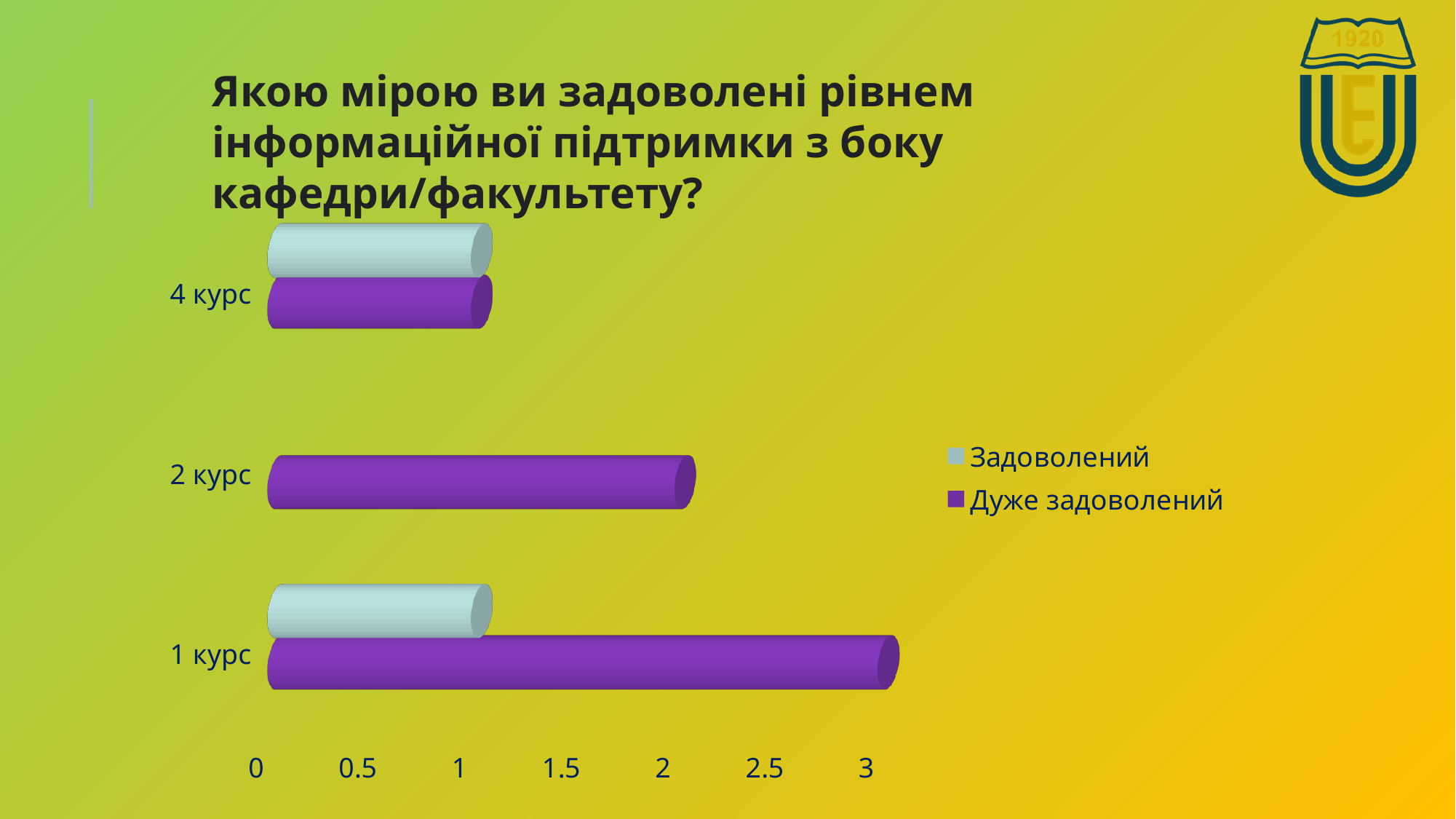
For 1 курс, which is larger: 'Задоволений' or 'Дуже задоволений'? Дуже задоволений Which course has no bar for 'Задоволений'? 2 курс Is the value for 'Задоволений' for 1 курс greater or less than 1.5? less Which course has the lowest value for 'Дуже задоволений'? 4 курс Is the value for 'Дуже задоволений' for 1 курс greater or less than 2.5? greater How many series does the legend list? 2 Which course has the highest value for 'Дуже задоволений'? 1 курс What are the two entries in the chart legend? Задоволений, Дуже задоволений How many categories (courses) are shown on the chart? 3 What kind of chart is shown on the slide? bar chart Is the value for 'Дуже задоволений' for 2 курс greater or less than 1.5? greater